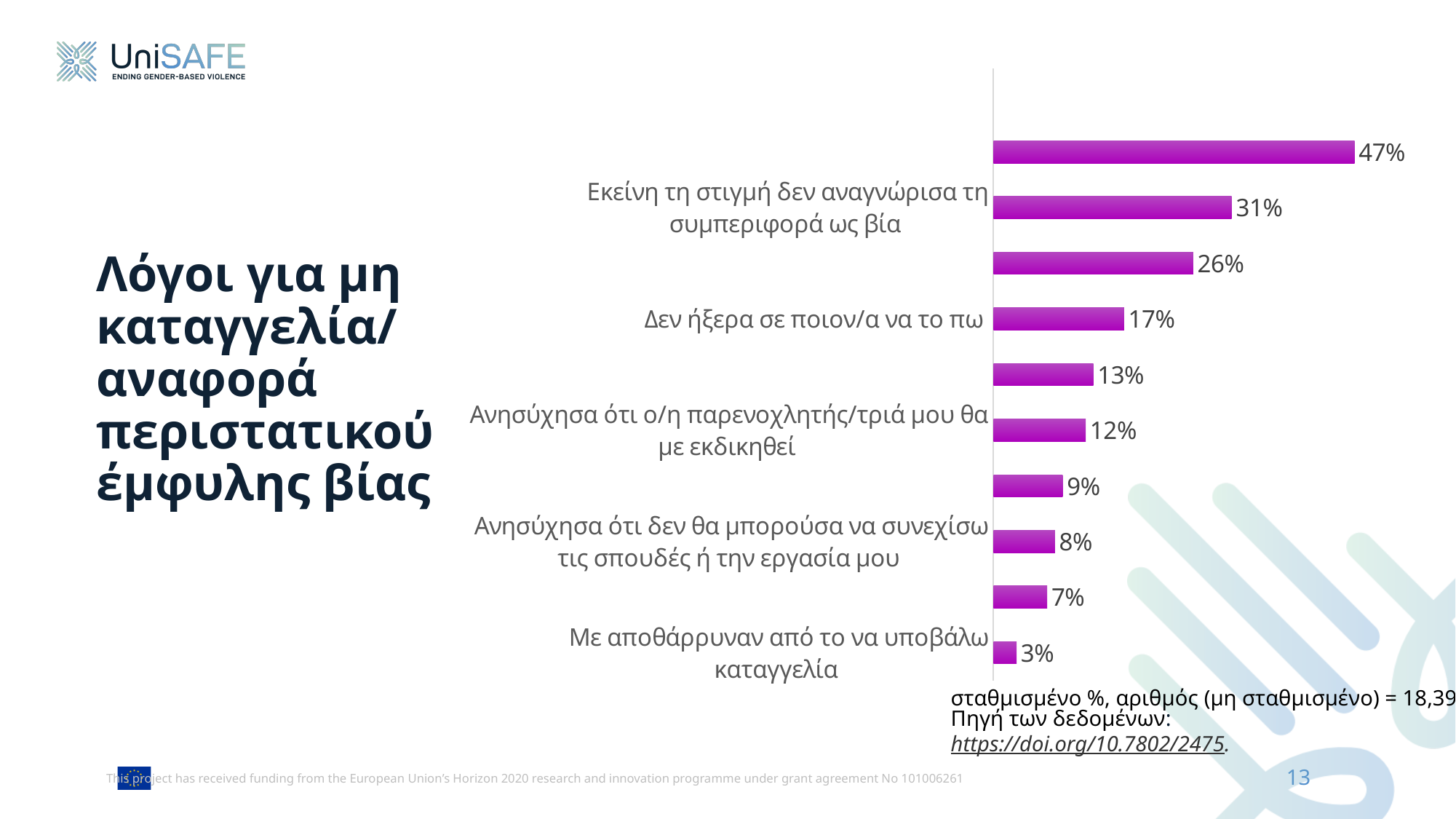
What kind of chart is shown on the slide? bar chart How many bars does the chart contain? 10 Which is larger: the value for "Δεν ήξερα σε ποιον/α να το πω" or the value for "Ανησύχησα ότι ο/η παρενοχλητής/τριά μου θα με εκδικηθεί"? Δεν ήξερα σε ποιον/α να το πω What is the value for "Δεν ήξερα σε ποιον/α να το πω"? 17% What is the value for "Ανησύχησα ότι ο/η παρενοχλητής/τριά μου θα με εκδικηθεί"? 12% Do the bar values increase or decrease from the top of the chart to the bottom? decrease What is the title of the slide? Λόγοι για μη καταγγελία/αναφορά περιστατικού έμφυλης βίας What is the value for "Με αποθάρρυναν από το να υποβάλω καταγγελία"? 3% What is the highest value shown in the chart? 47% What is the difference between the highest value (47%) and the second-highest value (31%)? 16% What is the value for "Ανησύχησα ότι δεν θα μπορούσα να συνεχίσω τις σπουδές ή την εργασία μου"? 8% What is the lowest value shown in the chart? 3%